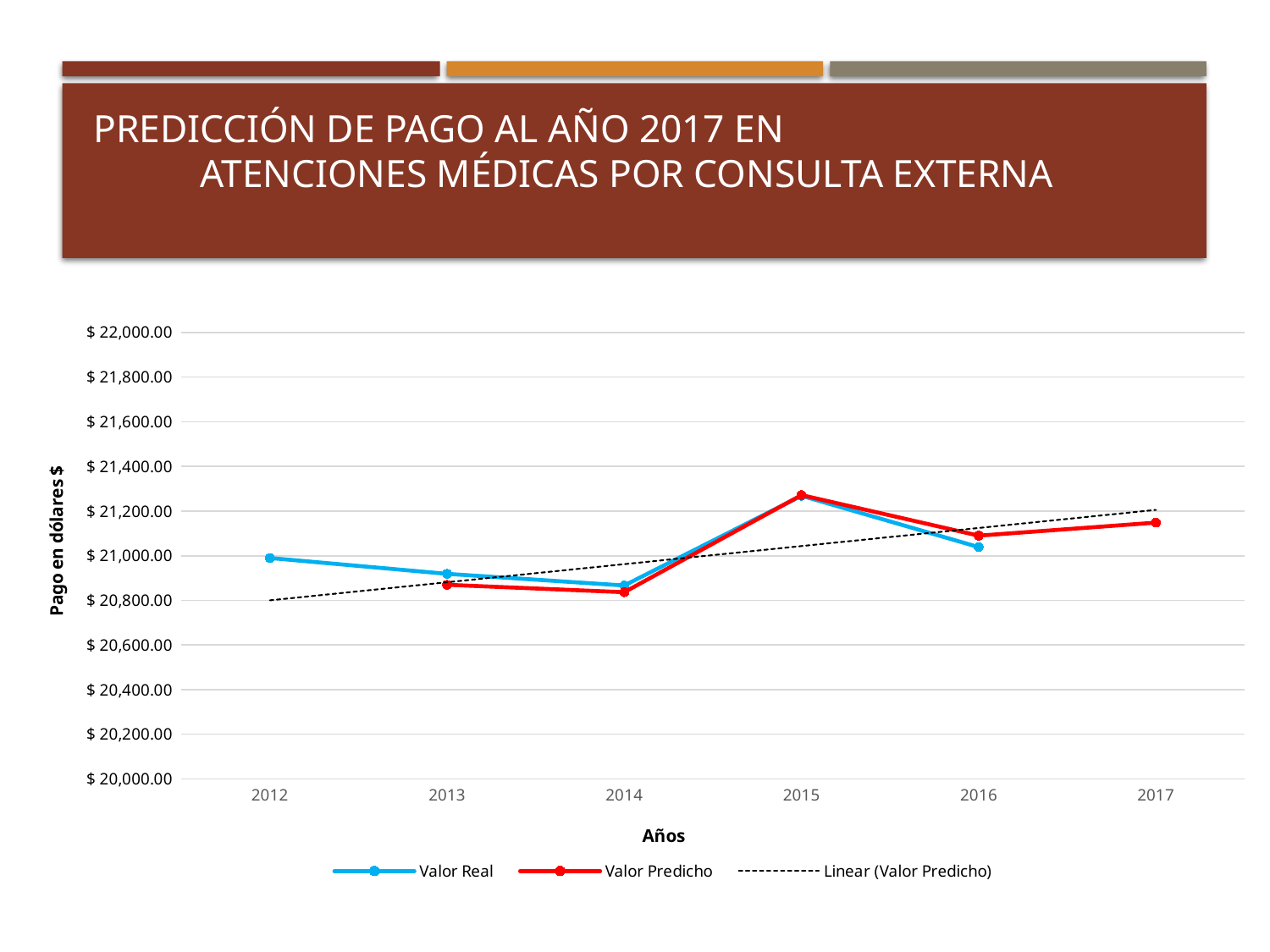
Is the Valor Predicho value for 2017 greater or less than $ 21,000.00? greater Does the Valor Real series rise or fall from 2012 to 2014? fall Is the Valor Real value for 2015 greater or less than $ 21,200.00? greater What kind of chart is shown on the slide? line chart Which is larger for Valor Predicho: the value in 2015 or the value in 2017? 2015 How many series does the legend list? 3 What is the title of the vertical axis? Pago en dólares $ Is the Valor Predicho value for 2014 greater or less than $ 21,000.00? less Does the dashed Linear (Valor Predicho) trendline rise or fall from 2012 to 2017? rise In which year does the Valor Predicho series reach its highest value? 2015 How many years are shown on the x axis? 6 In which year does the Valor Real series reach its highest value? 2015